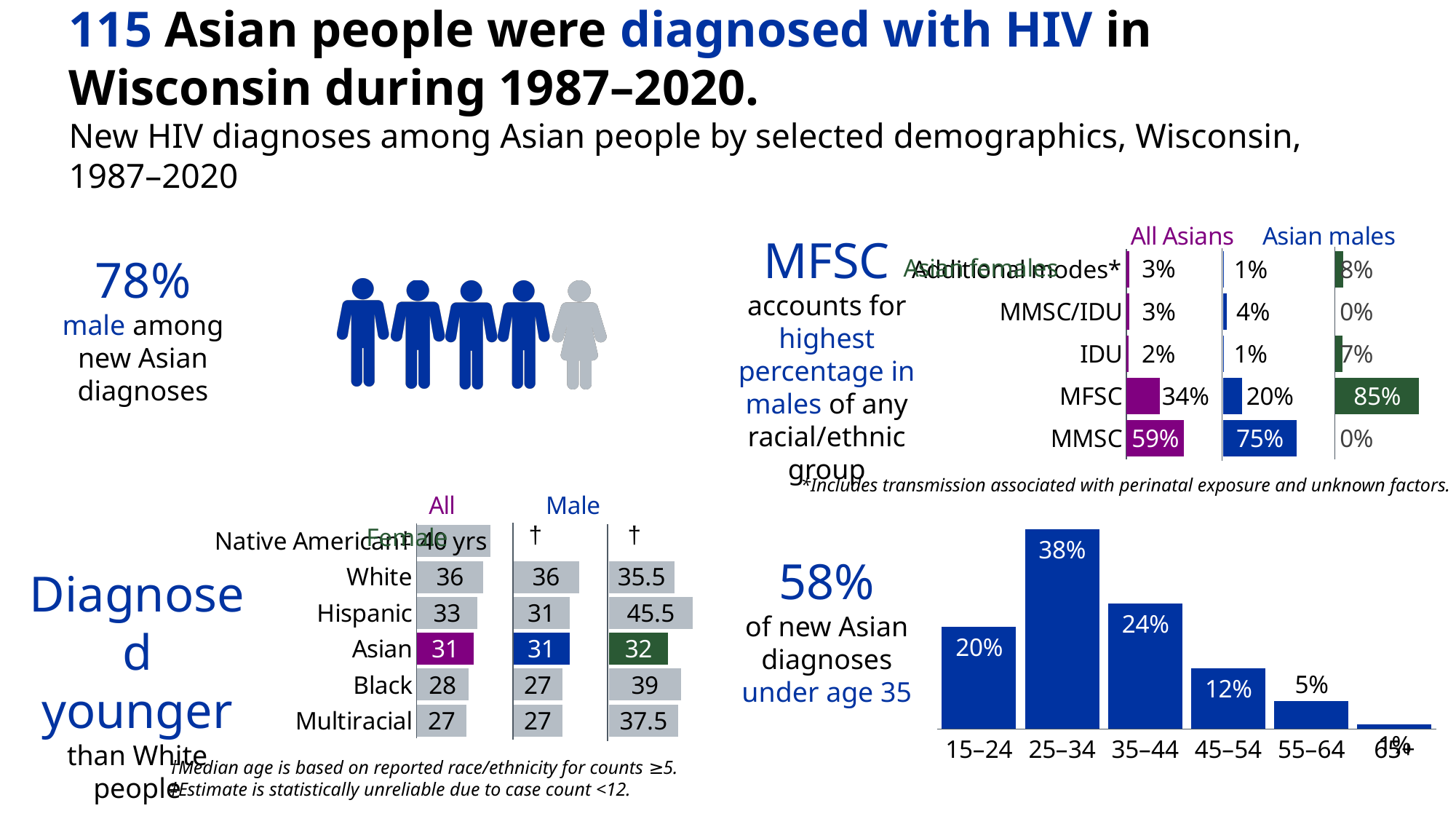
In the age group chart at the bottom right, which is larger, the value for 15–24 or the value for 45–54? 15–24 In the transmission category chart at the top right, what is the difference in percentage points between MMSC and MFSC for All Asians? 25 In the age group chart at the bottom right, what is the difference in percentage points between the 25–34 and 35–44 age groups? 14 In the transmission category chart at the top right, what percentage of Asian males is attributed to MFSC? 20% In the age group chart at the bottom right, which age group has the highest percentage of new Asian diagnoses? 25–34 In the age group chart at the bottom right, what percentage of new Asian diagnoses were in the 25–34 age group? 38% In the transmission category chart at the top right, what percentage of All Asians is attributed to MMSC? 59% In the age group chart at the bottom right, how many age groups are shown? 6 In the median age chart at the bottom left, which racial/ethnic group has the lowest median age in the All column? Multiracial What kind of chart is the age group chart at the bottom right? bar chart In the transmission category chart at the top right, which transmission category has the highest percentage among Asian males? MMSC In the median age chart at the bottom left, what is the median age at diagnosis for Asian people in the All column? 31